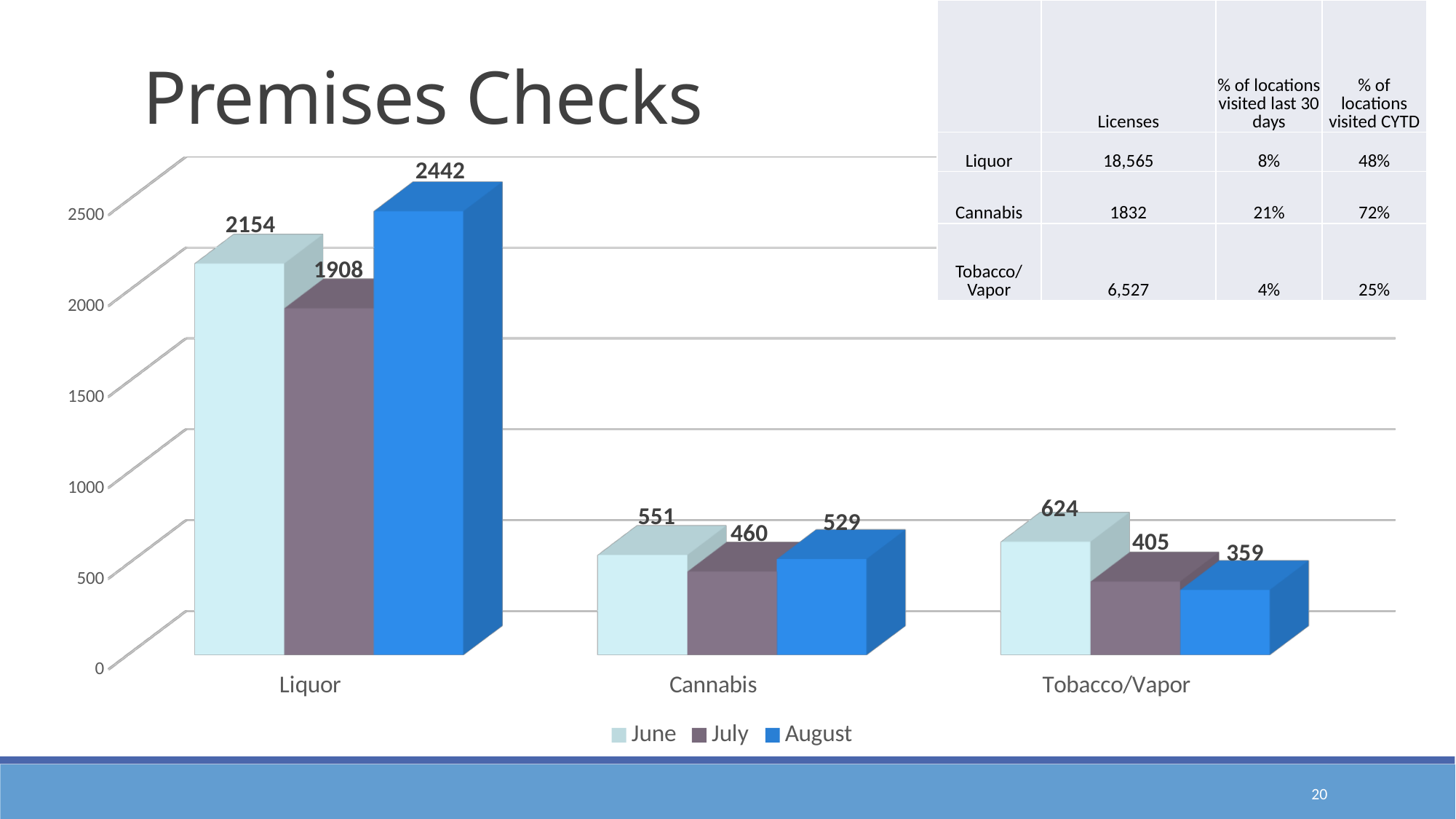
How many series does the legend list? 3 Is the value for Liquor in July greater or less than 1500? greater What is the value for Tobacco/Vapor in June? 624 What is the value for Cannabis in July? 460 Which is larger for Cannabis: the June value or the August value? June How many categories are shown on the x axis? 3 What is the value for Liquor in August? 2442 Which category has the lowest value in July? Tobacco/Vapor What is the difference between the June and July values for Liquor? 246 What kind of chart is shown on the slide? Bar chart Do the values for Tobacco/Vapor rise or fall from June to August? Fall Which category has the highest value in August? Liquor